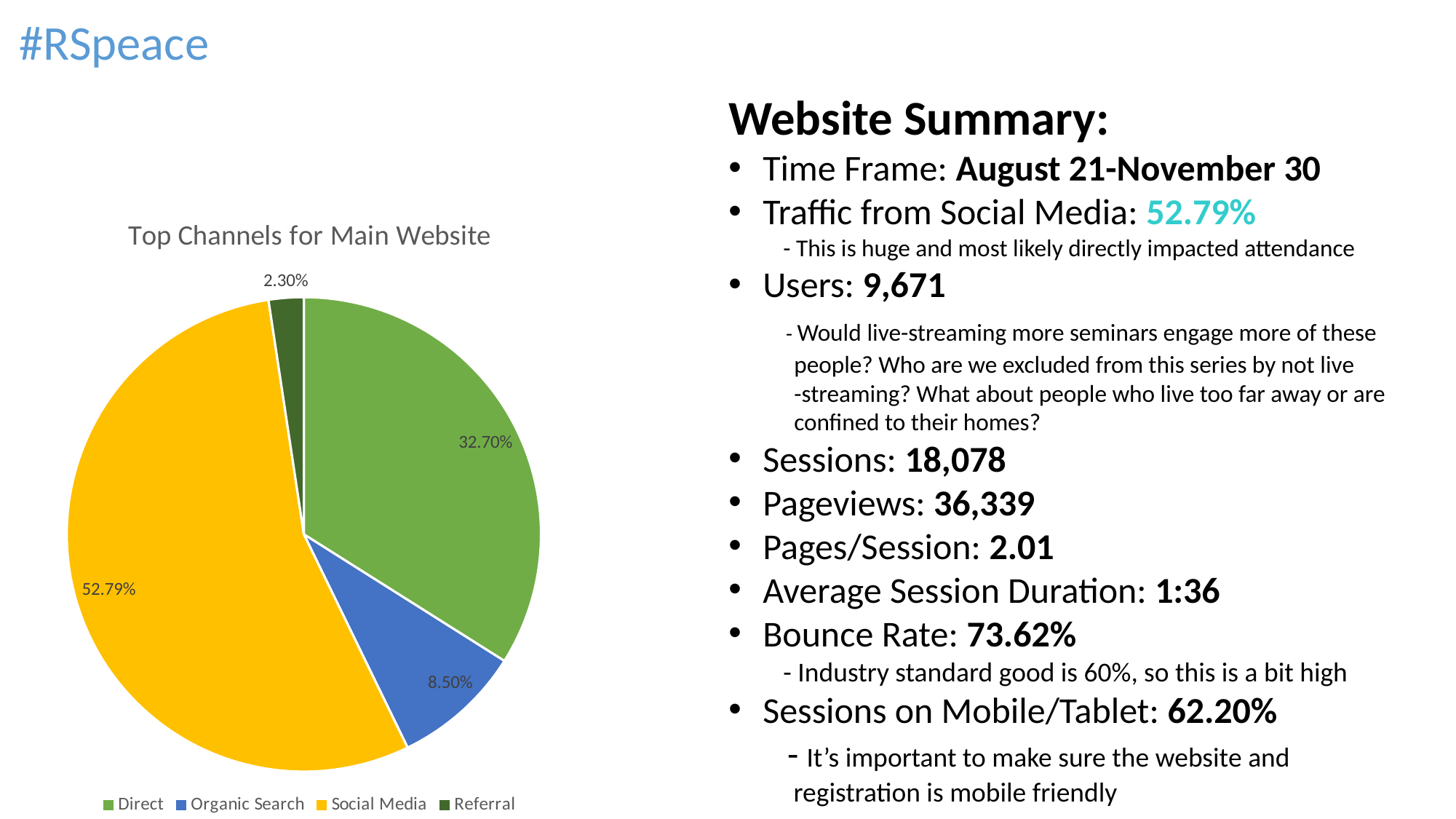
Which channel has the smallest slice of the pie? Referral What is the title of the pie chart? Top Channels for Main Website How many channels are shown in the pie chart? 4 What kind of chart is shown on the slide? pie chart What share of the pie does Social Media account for? 52.79% What colour is the Social Media slice in the pie chart? yellow Which channel has the largest slice of the pie? Social Media What share of the pie does Referral account for? 2.30% What share of the pie does Organic Search account for? 8.50% What share of the pie does Direct account for? 32.70% Which is larger, the Direct slice or the Organic Search slice? Direct What is the difference in percentage points between the Social Media and Direct slices? 20.09